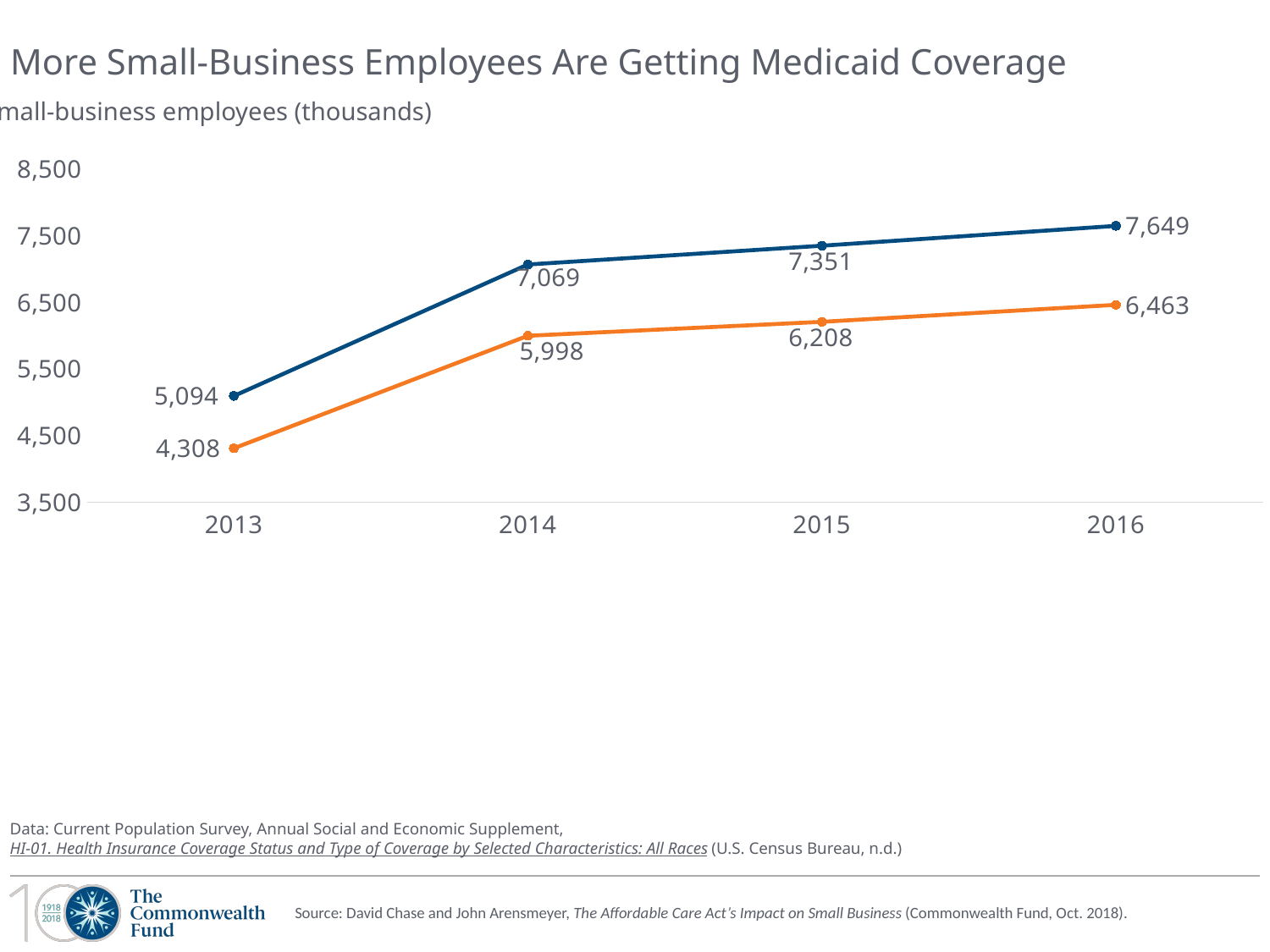
Which line has the larger value in 2015, the blue line or the orange line? the blue line How many years are shown on the x axis? 4 What is the value of the blue line in 2014? 7,069 What is the difference between the blue line and the orange line in 2016? 1,186 In which year is the orange line at its highest value? 2016 By how much did the blue line increase from 2013 to 2016? 2,555 What is the value of the orange line in 2015? 6,208 Do the values of the orange line rise or fall from 2013 to 2016? rise What type of chart is shown on the slide? line chart What is the value of the orange line in 2013? 4,308 In which year is the blue line at its lowest value? 2013 What is the value of the blue line in 2016? 7,649